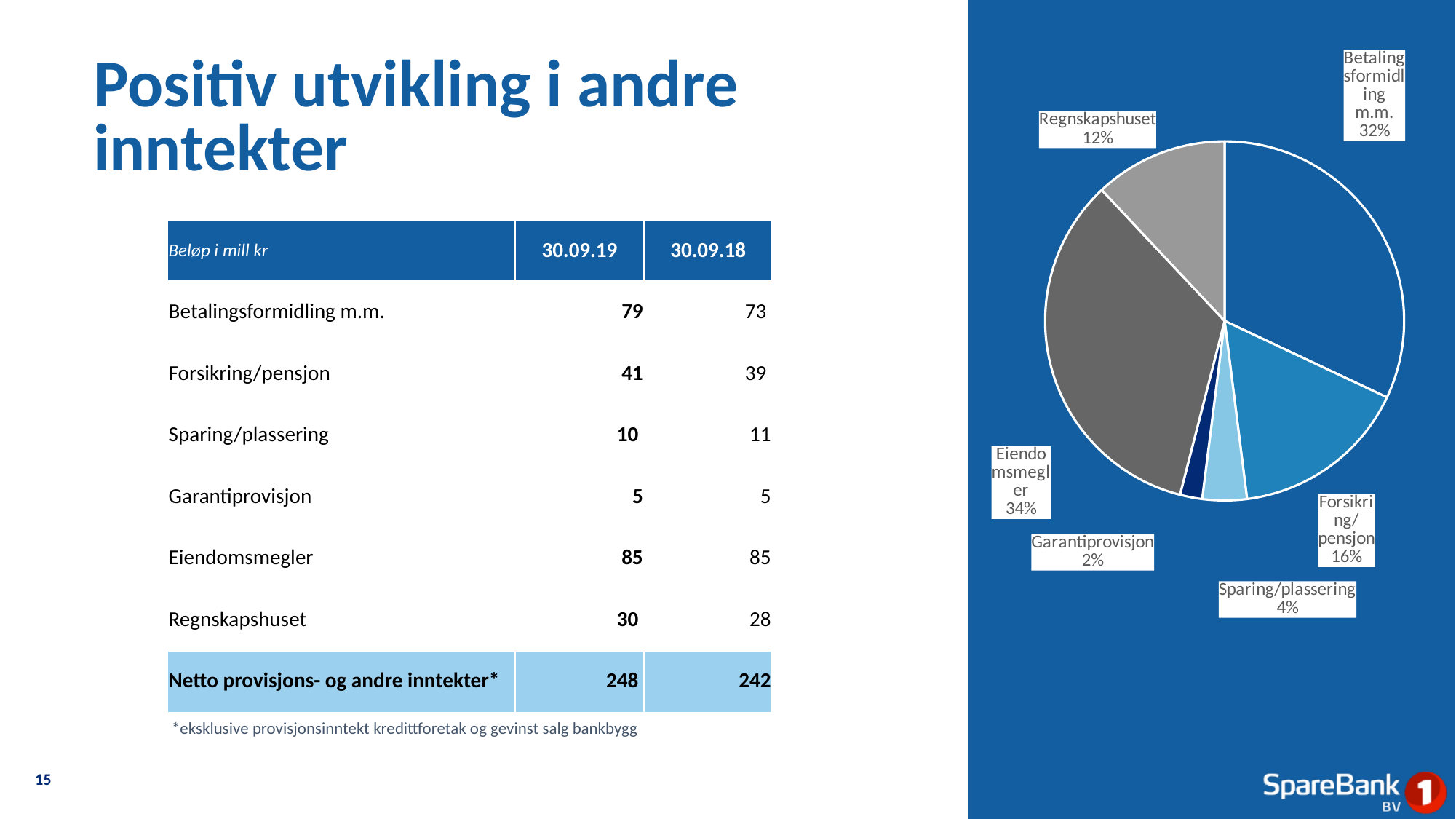
What share of the pie chart does Forsikring/pensjon represent? 16% What kind of chart is shown on the slide? Pie chart What share of the pie chart does Eiendomsmegler represent? 34% What share of the pie chart does Garantiprovisjon represent? 2% How many slices does the pie chart have? 6 Which slice of the pie chart is the smallest? Garantiprovisjon In the pie chart, what is the difference in percentage points between Forsikring/pensjon and Regnskapshuset? 4 percentage points In the pie chart, which is larger: Betalingsformidling m.m. or Forsikring/pensjon? Betalingsformidling m.m. Which slice of the pie chart is the largest? Eiendomsmegler